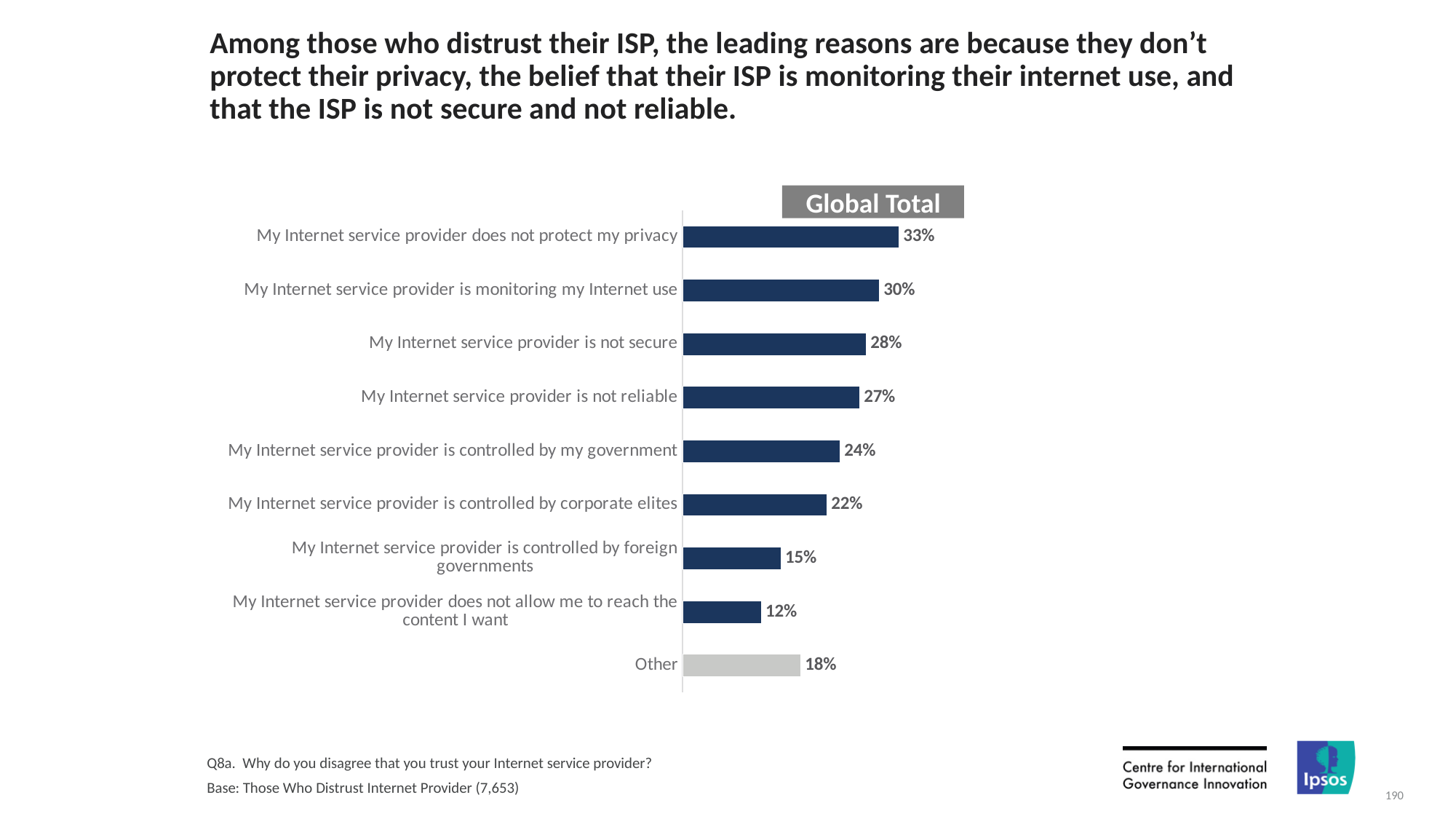
What is the difference between 'does not protect my privacy' (33%) and 'is not secure' (28%)? 5 percentage points What percentage of respondents said their Internet service provider does not protect their privacy? 33% What percentage cited that their Internet service provider is controlled by foreign governments? 15% Which is larger: 'controlled by my government' or 'controlled by corporate elites'? Controlled by my government What is the value shown for 'Other'? 18% Which reason has the lowest percentage? My Internet service provider does not allow me to reach the content I want What is the difference between 'is not reliable' and 'does not allow me to reach the content I want'? 15 percentage points What is the value for 'My Internet service provider is monitoring my Internet use'? 30% How many reasons (bars) are shown in the chart? 9 What type of chart is shown on the slide? Bar chart Which reason has the highest percentage? My Internet service provider does not protect my privacy What is the column header shown above the bars? Global Total